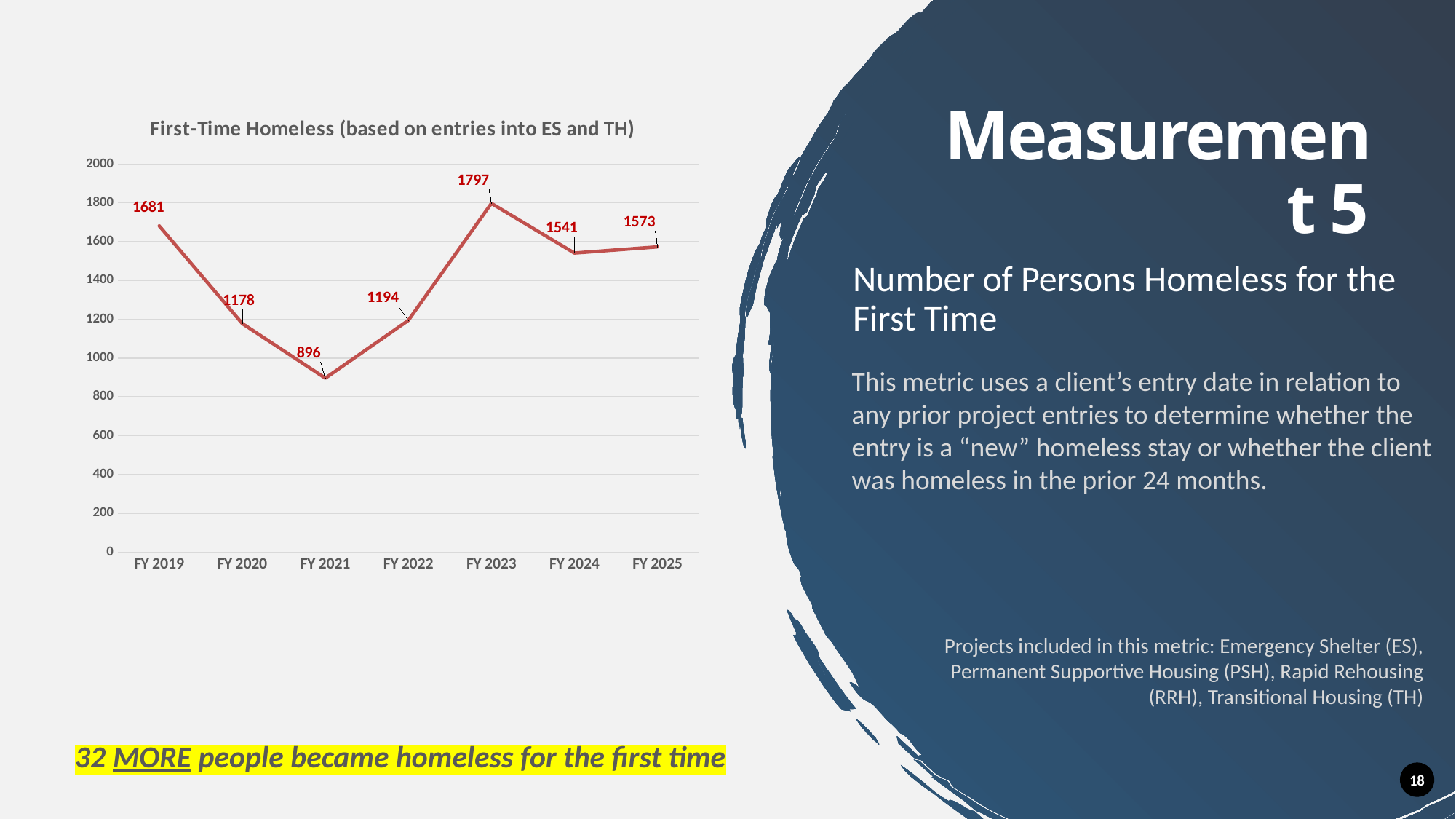
What kind of chart is shown? line chart Which fiscal year has the lowest value? FY 2021 What is the value for FY 2021? 896 What is the difference between the FY 2023 and FY 2022 values? 603 What is the value for FY 2019? 1681 Which fiscal year has the highest value? FY 2023 What is the difference between the FY 2025 and FY 2024 values? 32 Is the value for FY 2021 greater or less than 1000? less Which is larger, the value for FY 2020 or FY 2022? FY 2022 What is the title of the chart? First-Time Homeless (based on entries into ES and TH) How many fiscal years are plotted on the chart? 7 What is the value for FY 2025? 1573